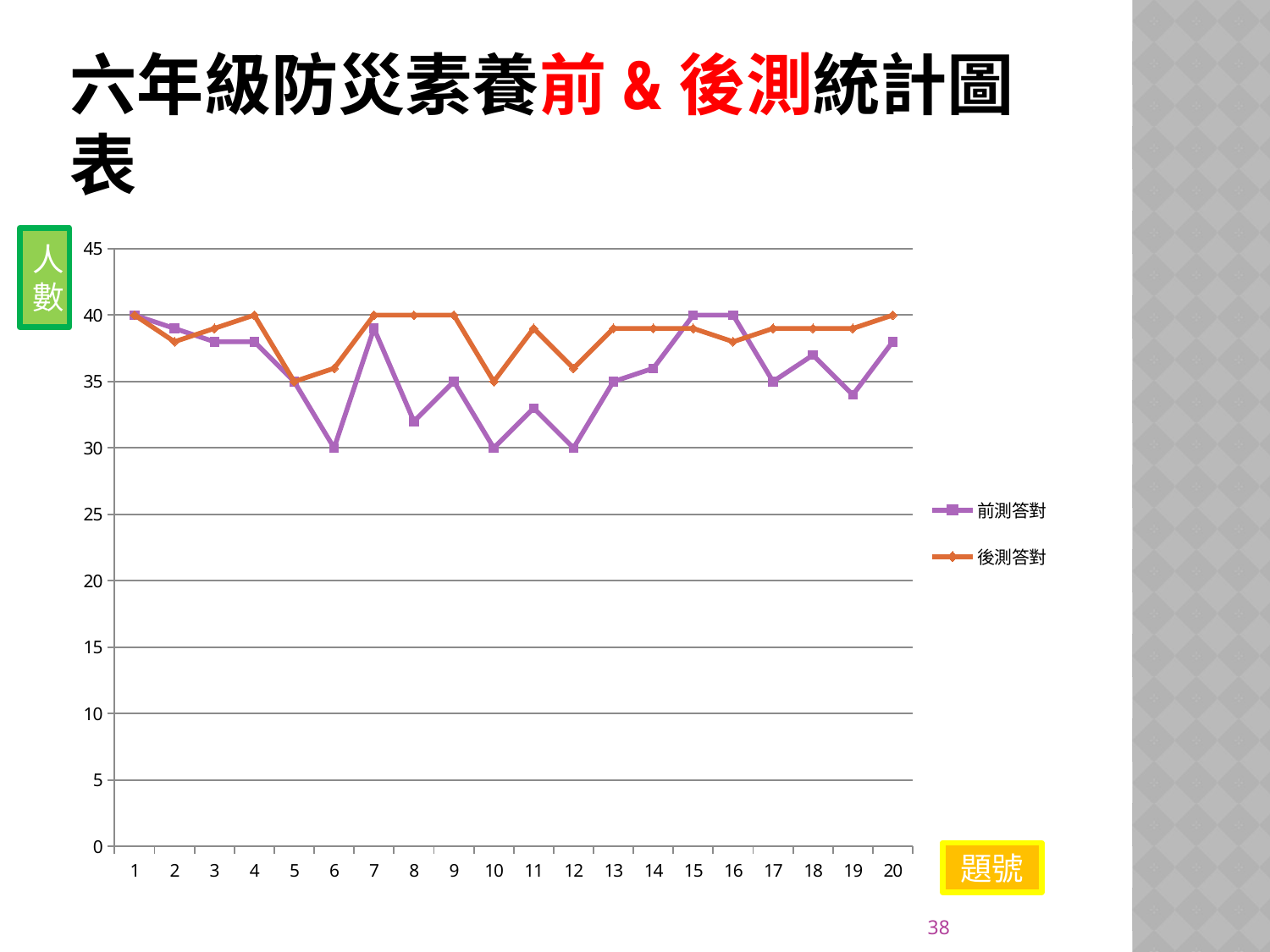
Is the value of 前測答對 for question 8 greater or less than 35? less What is the value of 後測答對 for question 10? 35 Is the value of 後測答對 for question 2 greater or less than 35? greater What are the two series named in the legend? 前測答對 and 後測答對 What is the value of 後測答對 for question 7? 40 What is the value of 前測答對 for question 6? 30 What kind of chart is shown on the slide? line chart What is the value of 前測答對 for question 1? 40 How many series does the legend list? 2 What label is shown for the vertical axis? 人數 For question 8, which series has the larger value, 前測答對 or 後測答對? 後測答對 How many question numbers (題號) are plotted along the x axis? 20